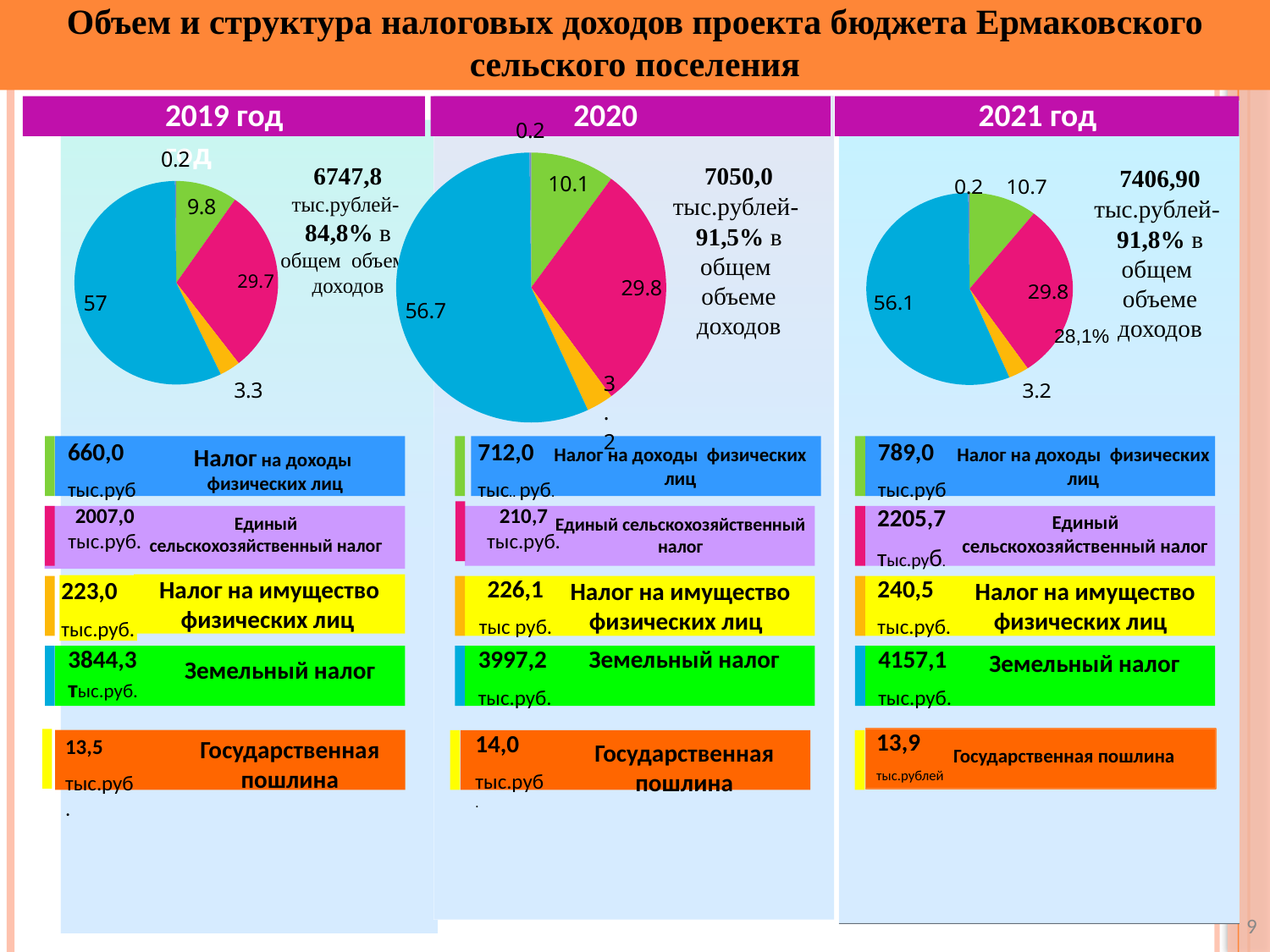
Which is larger: the largest slice of the 2019 год pie chart or the largest slice of the 2021 год pie chart? 2019 год (57) In the 2020 pie chart, what is the value of the largest slice? 56.7 In the 2019 год pie chart, what value is shown on the orange slice? 3.3 In the 2020 pie chart, what value is shown on the green slice? 10.1 In the 2021 год pie chart, what value is shown on the pink slice? 29.8 In the 2019 год pie chart, what is the value of the smallest slice? 0.2 In the 2019 год pie chart, what is the value of the largest slice? 57 What kind of chart is shown under the heading "2019 год"? pie chart In the 2020 pie chart, what is the difference between the pink slice (29.8) and the green slice (10.1)? 19.7 How many pie charts are shown on the slide? 3 How many slices does the pie chart for 2019 год have? 5 In the 2021 год pie chart, what is the value of the largest slice? 56.1